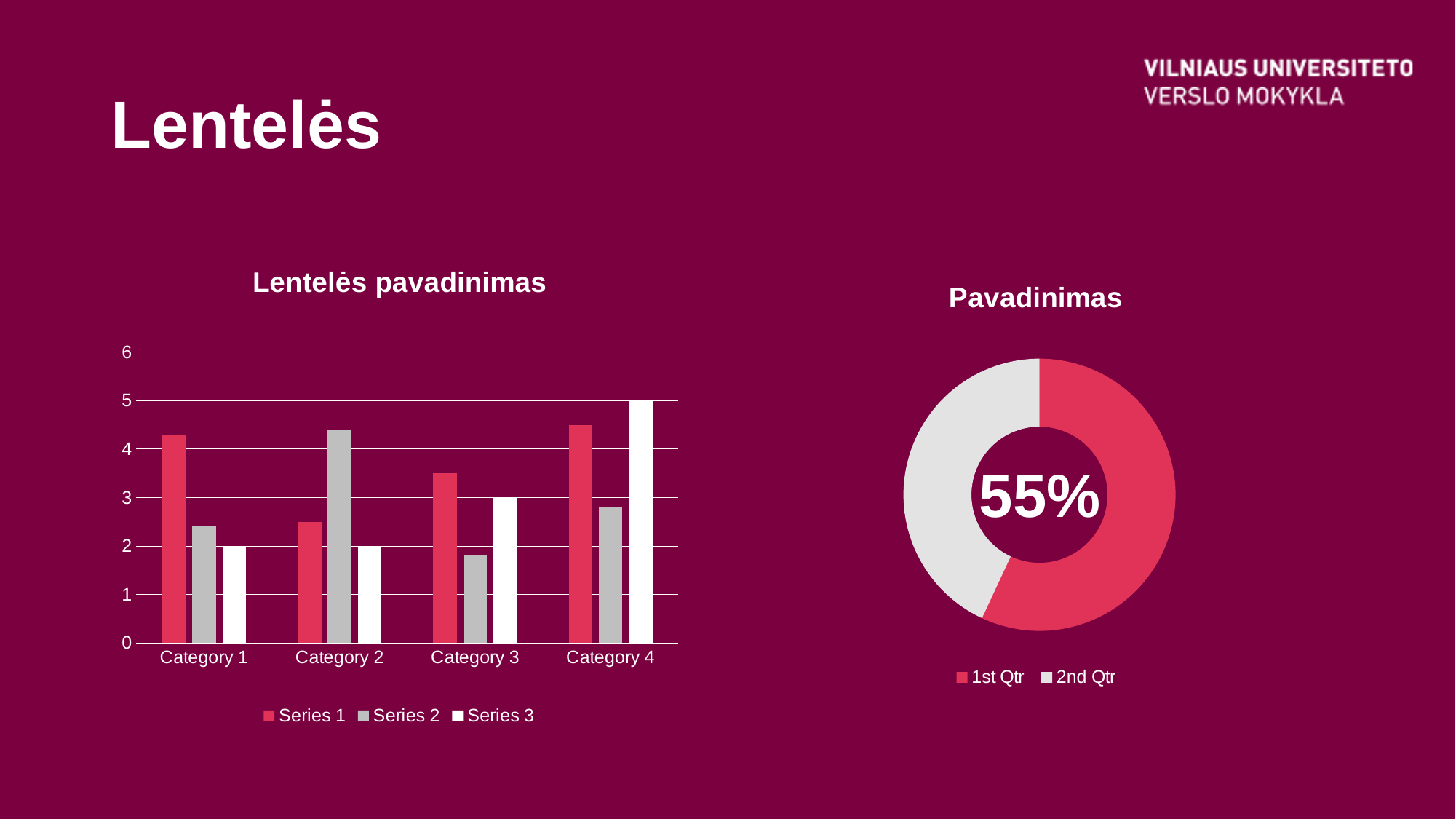
In the chart titled "Lentelės pavadinimas", how many series does the legend list? 3 In the chart titled "Lentelės pavadinimas", what is the value of Series 3 for Category 3? 3 In the chart titled "Lentelės pavadinimas", which category has the highest value for Series 3? Category 4 What kind of chart is the one titled "Lentelės pavadinimas"? Bar chart In the chart titled "Lentelės pavadinimas", which category has the lowest value for Series 2? Category 3 In the chart titled "Lentelės pavadinimas", is the value of Series 2 for Category 3 greater or less than 2? less In the chart titled "Lentelės pavadinimas", how many categories are shown on the x axis? 4 In the chart titled "Lentelės pavadinimas", which category has the highest value for Series 2? Category 2 In the chart titled "Lentelės pavadinimas", what is the value of Series 3 for Category 4? 5 In the chart titled "Pavadinimas", how many entries does the legend list? 2 In the chart titled "Lentelės pavadinimas", for Category 2, which is larger: Series 1 or Series 2? Series 2